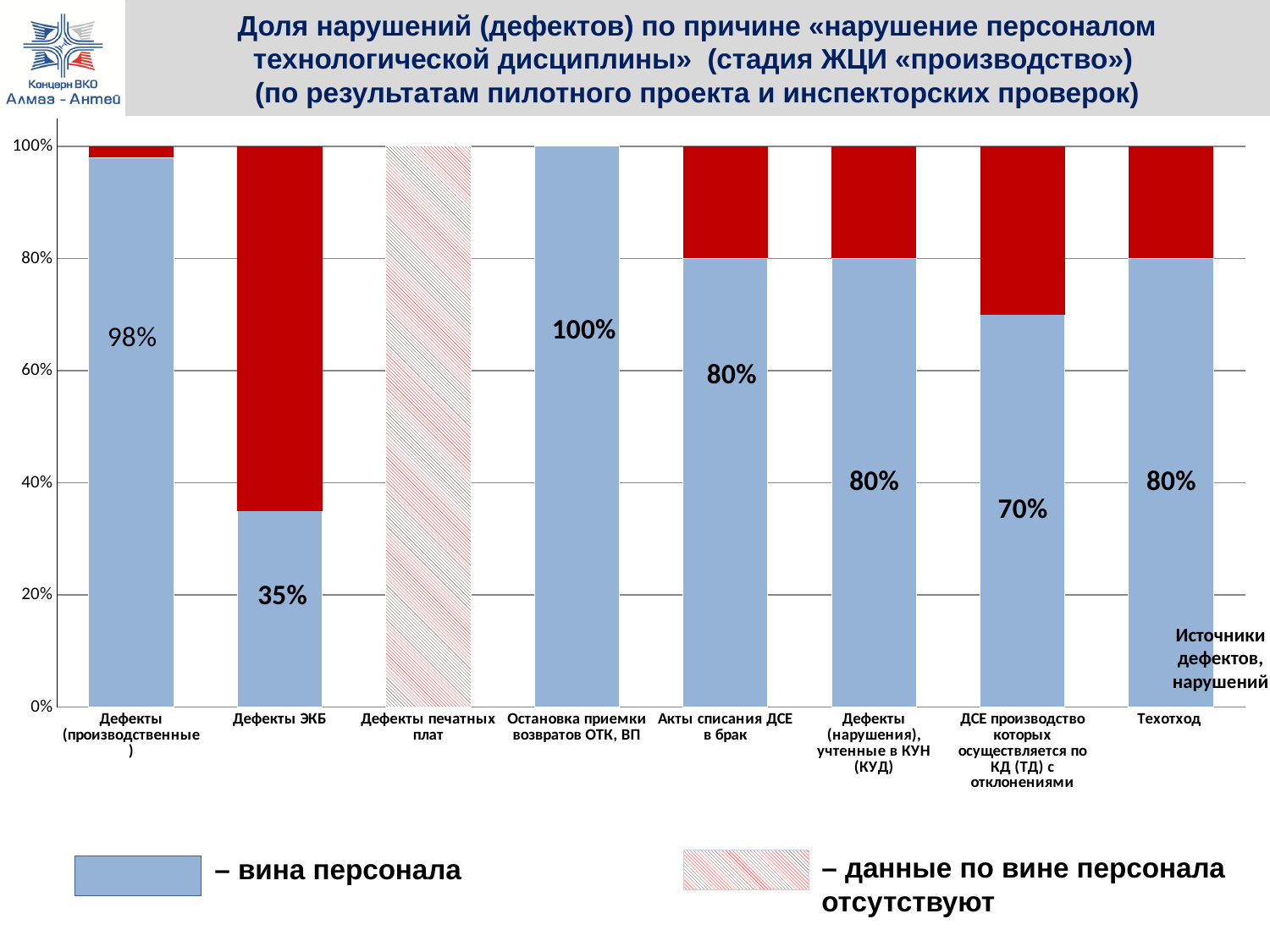
What share of defects is attributed to personnel fault for the category «Дефекты (производственные)»? 98% Which has a larger personnel-fault share: «Акты списания ДСЕ в брак» or «ДСЕ производство которых осуществляется по КД (ТД) с отклонениями»? Акты списания ДСЕ в брак How many categories are shown on the x axis of the chart? 8 Which category has the highest share of defects attributed to personnel fault? Остановка приемки возвратов ОТК, ВП Among the categories with a printed value, which has the lowest share of defects attributed to personnel fault? Дефекты ЭКБ What type of chart is shown on the slide? Stacked bar chart For which category does the chart indicate that data on personnel fault is absent (hatched bar)? Дефекты печатных плат What share of defects is attributed to personnel fault for the category «ДСЕ производство которых осуществляется по КД (ТД) с отклонениями»? 70% What share of defects is attributed to personnel fault (вина персонала) for the category «Дефекты ЭКБ»? 35% What share of defects is attributed to personnel fault for the category «Техотход»? 80% Is the personnel-fault share for «Дефекты ЭКБ» greater or less than 40%? less What is the difference between the personnel-fault share for «Дефекты (производственные)» and for «Дефекты ЭКБ»? 63%